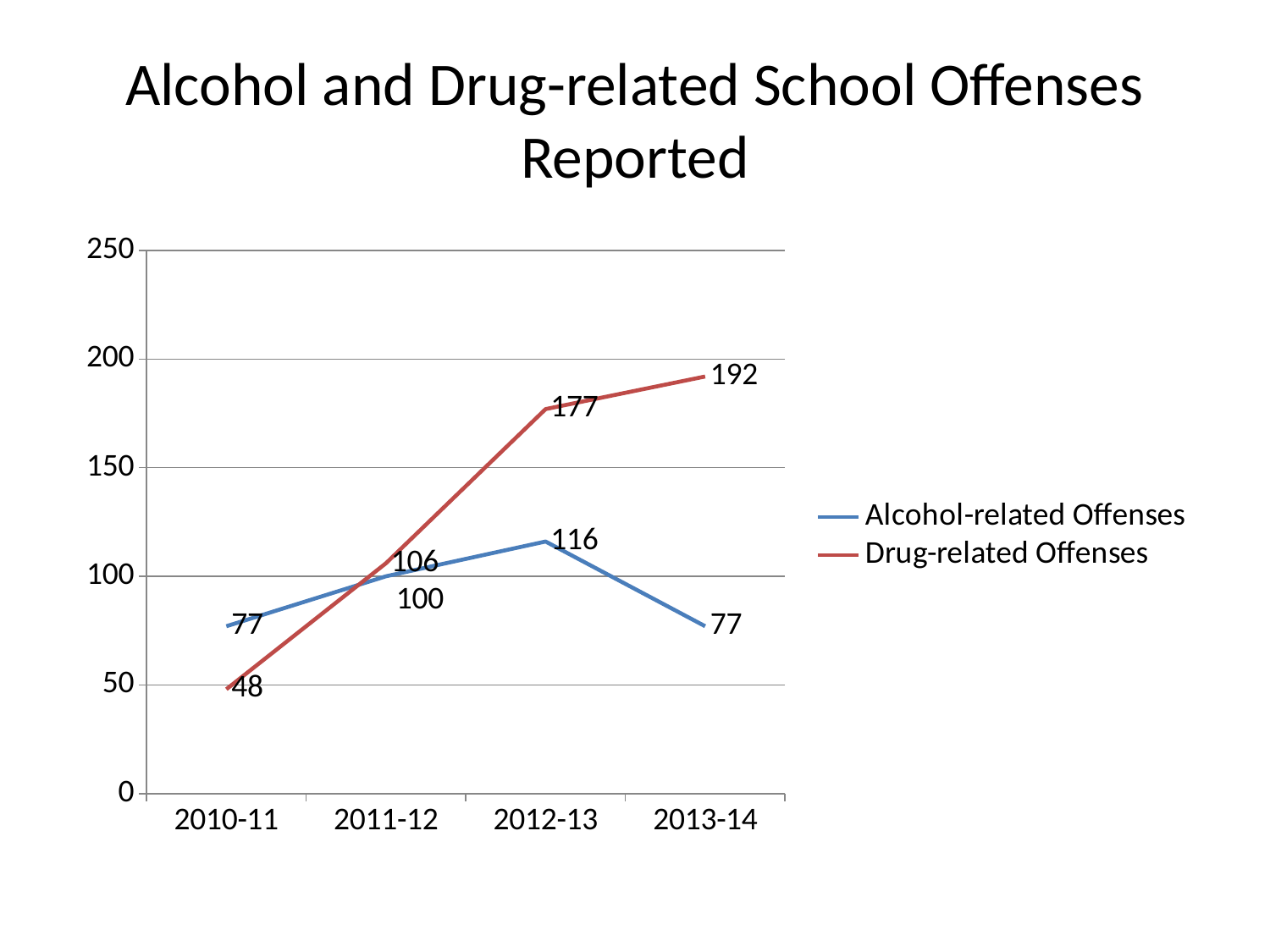
What type of chart is shown on the slide? line chart Which series had the larger value in 2010-11, Alcohol-related Offenses or Drug-related Offenses? Alcohol-related Offenses In which school year were Drug-related Offenses lowest? 2010-11 What is the value for Drug-related Offenses in 2010-11? 48 What is the difference between Drug-related Offenses and Alcohol-related Offenses in 2013-14? 115 How many series does the legend list? 2 How many school years are shown on the x axis? 4 What is the title of the chart? Alcohol and Drug-related School Offenses Reported Do Drug-related Offenses rise or fall from 2010-11 to 2013-14? rise What is the value for Alcohol-related Offenses in 2012-13? 116 In which school year were Drug-related Offenses highest? 2013-14 What is the value for Drug-related Offenses in 2013-14? 192